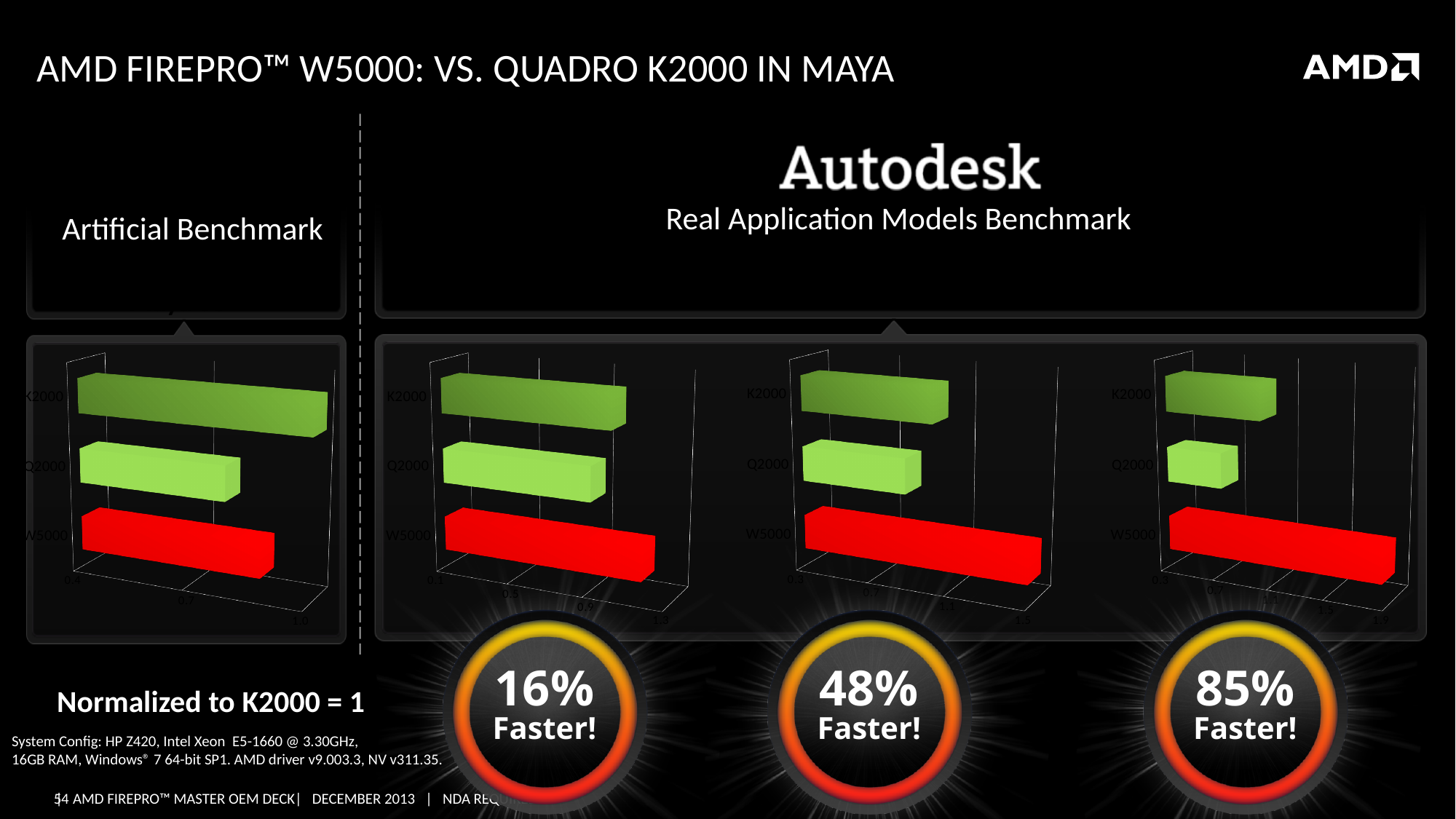
In the first chart under 'Real Application Models Benchmark' (left of the three), which category has the shortest bar? Q2000 In the leftmost chart under 'Artificial Benchmark', is the value for Q2000 greater or less than 1.0? less In the leftmost chart under 'Artificial Benchmark', which category has the shortest bar? Q2000 According to the note on the slide, the chart values are normalized to which category equal to 1? K2000 In the leftmost chart under 'Artificial Benchmark', which category has the longest bar? K2000 What kind of chart is the leftmost chart under 'Artificial Benchmark'? bar chart How many bar charts are shown on the slide in total? 4 In the rightmost chart under 'Real Application Models Benchmark', which category has the longest bar? W5000 In the rightmost chart under 'Real Application Models Benchmark', is the value for Q2000 greater or less than 1.1? less In the middle chart under 'Real Application Models Benchmark', which bar is longer, K2000 or Q2000? K2000 In the rightmost chart under 'Real Application Models Benchmark', is the value for W5000 greater or less than 1.1? greater How many categories does the leftmost chart under 'Artificial Benchmark' show? 3